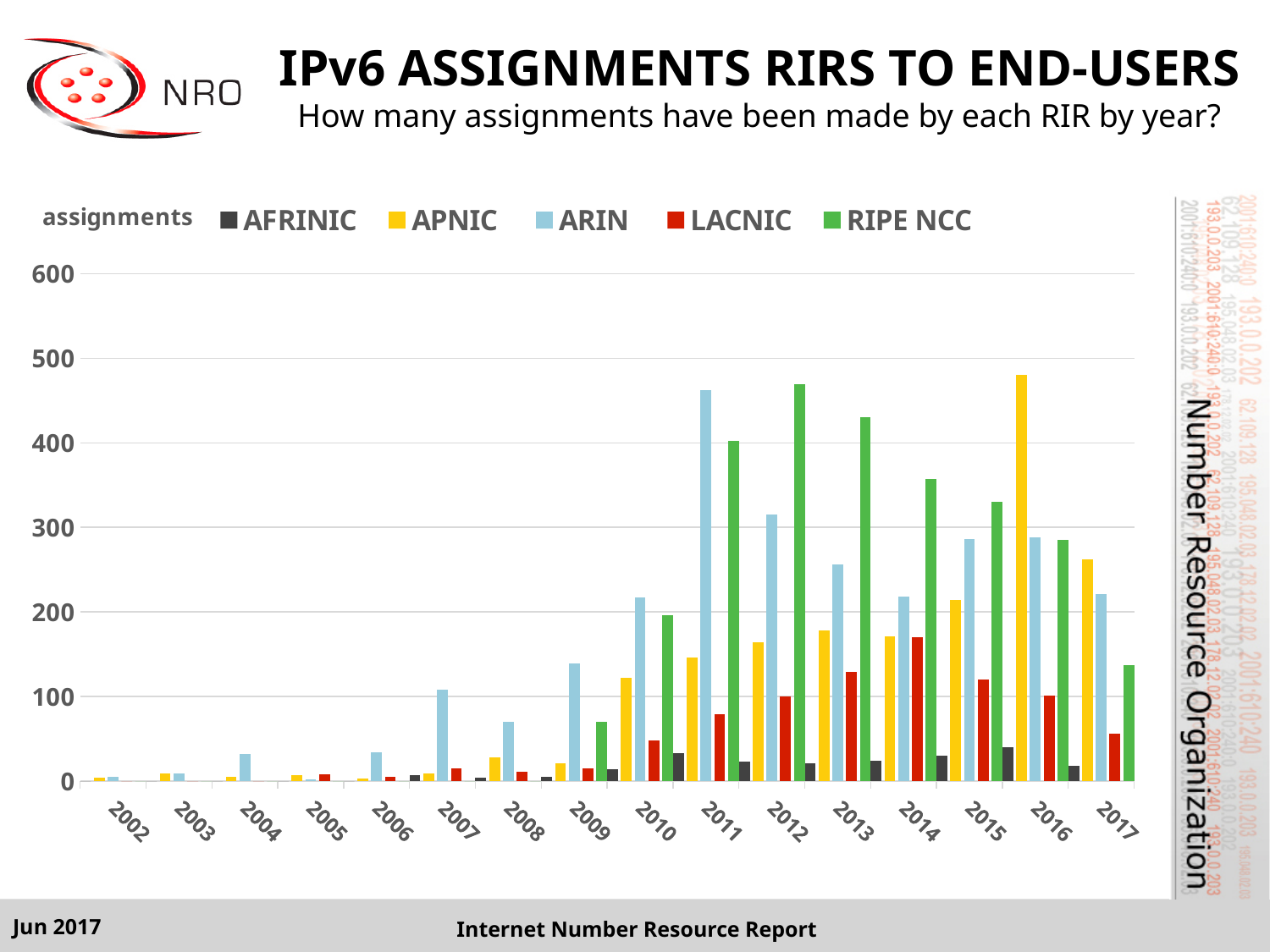
Is the value for RIPE NCC in 2012 greater or less than 400? greater How many years are shown along the x axis? 16 Which RIR has the highest value in 2013? RIPE NCC Which RIR has the highest value in 2017? APNIC How many series does the legend list? 5 Is the value for ARIN in 2011 greater or less than 400? greater Is the value for LACNIC in 2014 greater or less than 100? greater What kind of chart is shown on the slide? bar chart Which RIR has the lowest value in 2015? AFRINIC In 2011, which is larger: ARIN or RIPE NCC? ARIN In 2016, which is larger: APNIC or ARIN? APNIC